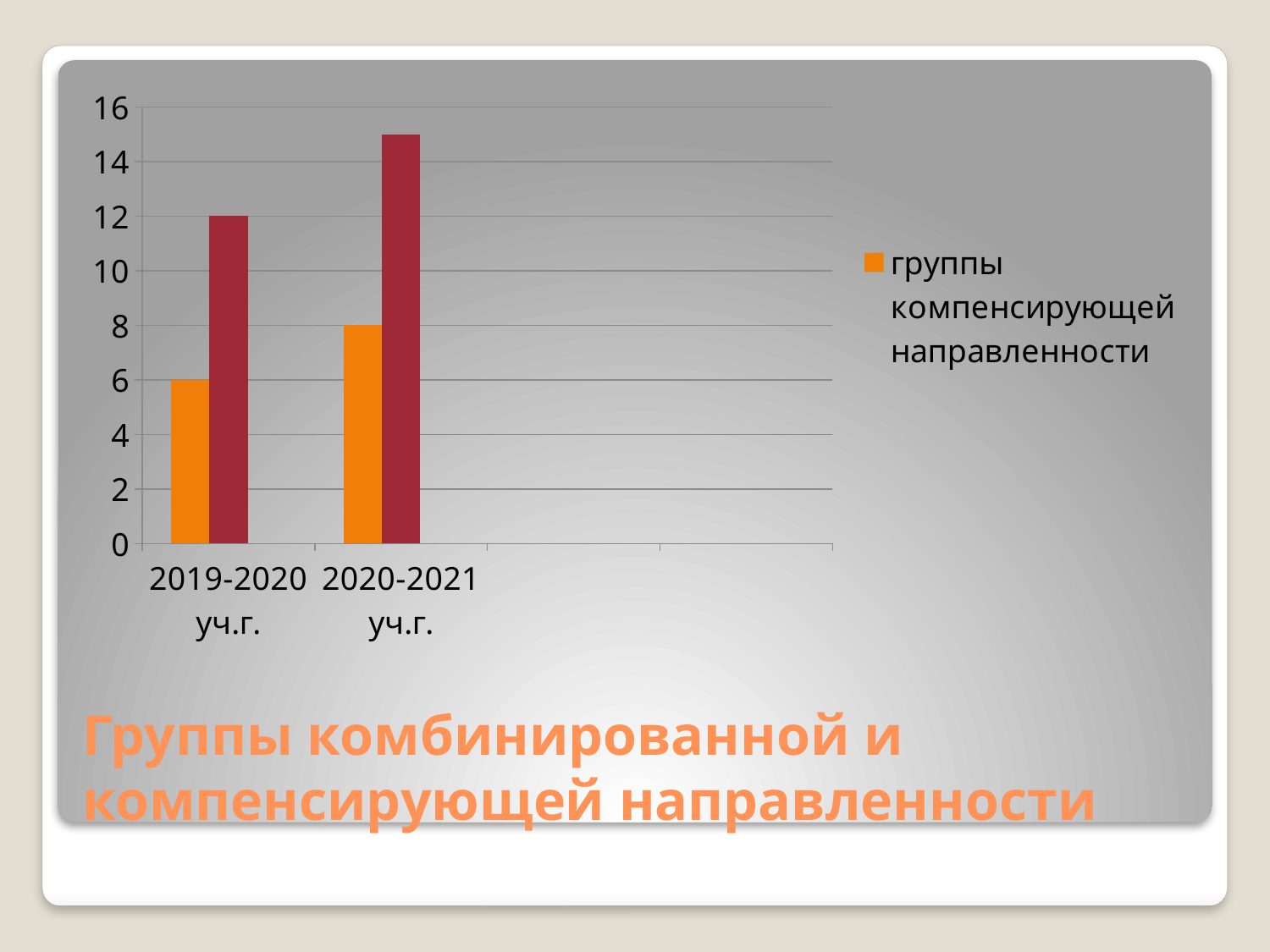
What is the value for группы компенсирующей направленности in 2020-2021 уч.г.? 8 Is the value for группы компенсирующей направленности in 2019-2020 уч.г. greater or less than 8? less Do the values for группы компенсирующей направленности rise or fall from 2019-2020 уч.г. to 2020-2021 уч.г.? rise What kind of chart is shown on the slide? bar chart Which year has the higher value for группы компенсирующей направленности, 2019-2020 уч.г. or 2020-2021 уч.г.? 2020-2021 уч.г. How many series does the legend list? 1 What is the value for группы компенсирующей направленности in 2019-2020 уч.г.? 6 By how much did the value for группы компенсирующей направленности increase from 2019-2020 уч.г. to 2020-2021 уч.г.? 2 Is the value of the dark red bar for 2020-2021 уч.г. greater or less than 14? greater What is the value of the dark red bar for 2019-2020 уч.г.? 12 What is the title of the slide? Группы комбинированной и компенсирующей направленности How many categories are shown on the x axis? 2